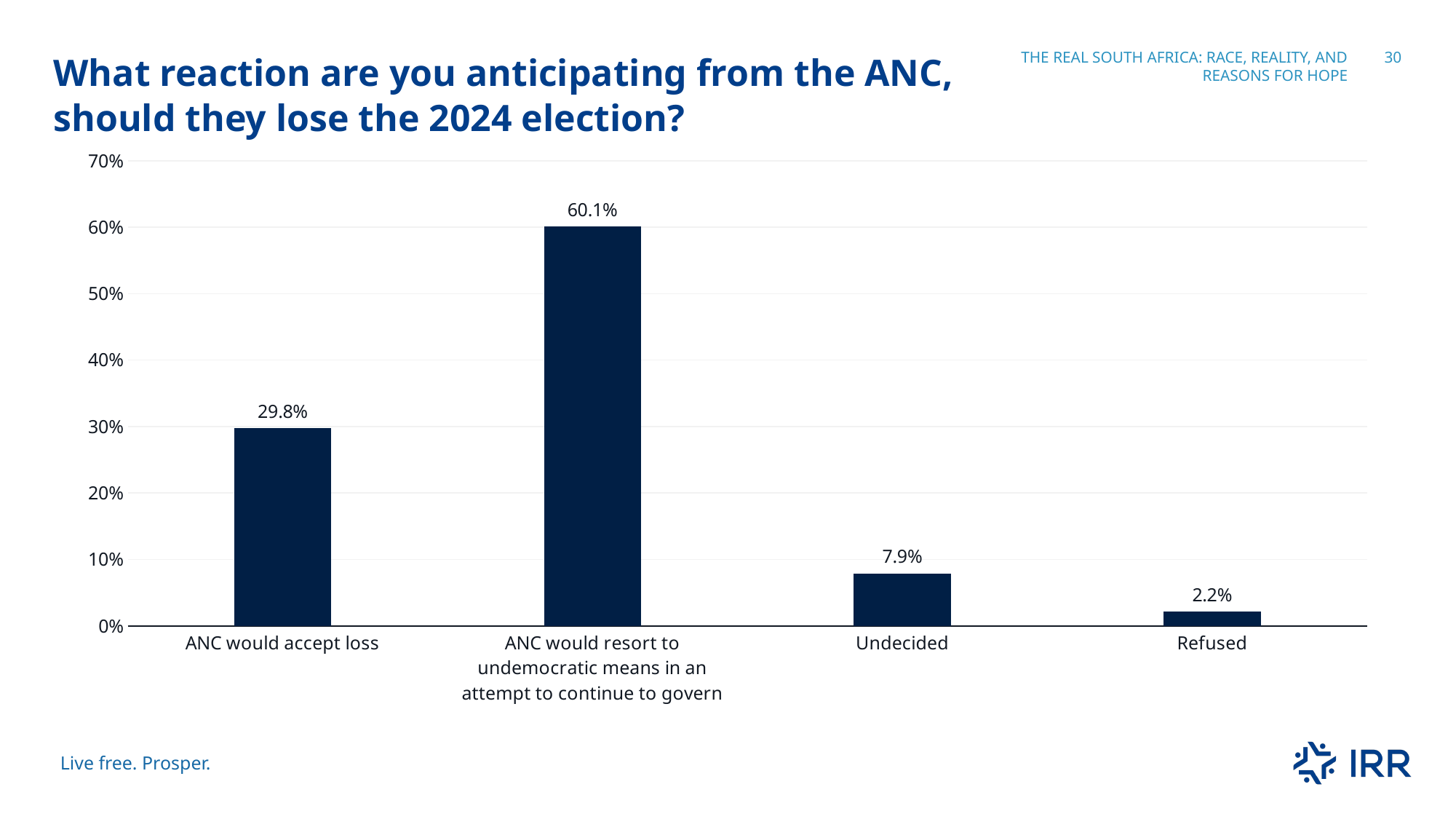
Which is larger, the value for Undecided or the value for Refused? Undecided What percentage of respondents said the ANC would accept loss? 29.8% Which category has the lowest value? Refused What is the value for Undecided? 7.9% Which category has the highest value? ANC would resort to undemocratic means in an attempt to continue to govern What is the difference between the value for 'ANC would resort to undemocratic means in an attempt to continue to govern' and the value for 'ANC would accept loss'? 30.3% What percentage of respondents said the ANC would resort to undemocratic means in an attempt to continue to govern? 60.1% What is the difference between the values for Undecided and Refused? 5.7% What kind of chart is shown on the slide? Bar chart What is the value for Refused? 2.2% What is the title of the slide? What reaction are you anticipating from the ANC, should they lose the 2024 election? How many categories are shown on the x axis? 4